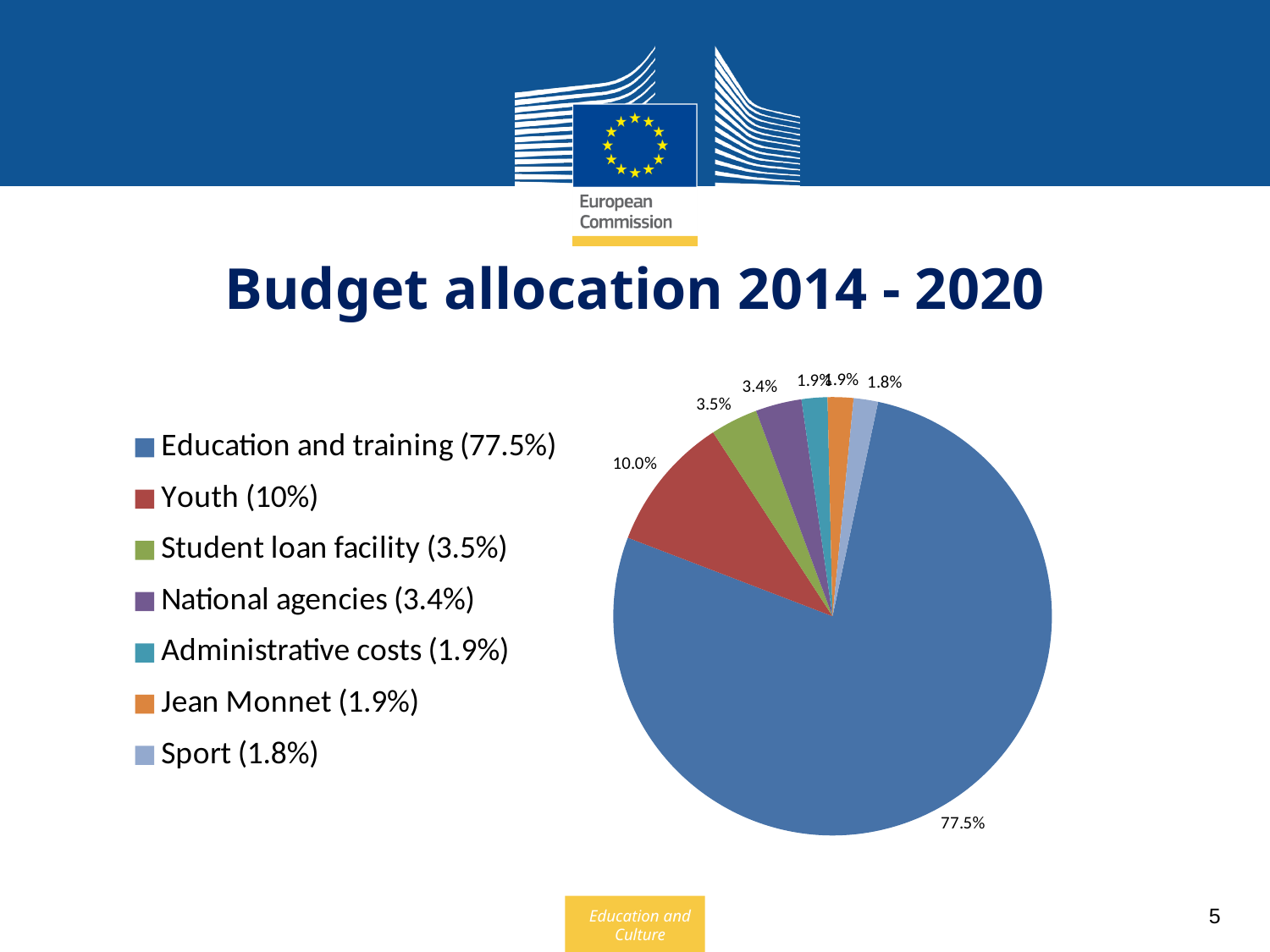
How many categories are shown in the pie chart? 7 What percentage of the budget is allocated to the Student loan facility? 3.5% What percentage of the budget is allocated to Youth? 10.0% What percentage of the budget is allocated to Education and training? 77.5% Which has a larger share of the budget, Student loan facility or National agencies? Student loan facility What percentage of the budget is allocated to National agencies? 3.4% How many percentage points larger is the Education and training share than the Youth share? 67.5 percentage points What kind of chart is shown on the slide? pie chart What is the title of the chart on the slide? Budget allocation 2014 - 2020 What percentage of the budget is allocated to Sport? 1.8% Which category receives the largest share of the budget? Education and training Which category receives the smallest share of the budget? Sport